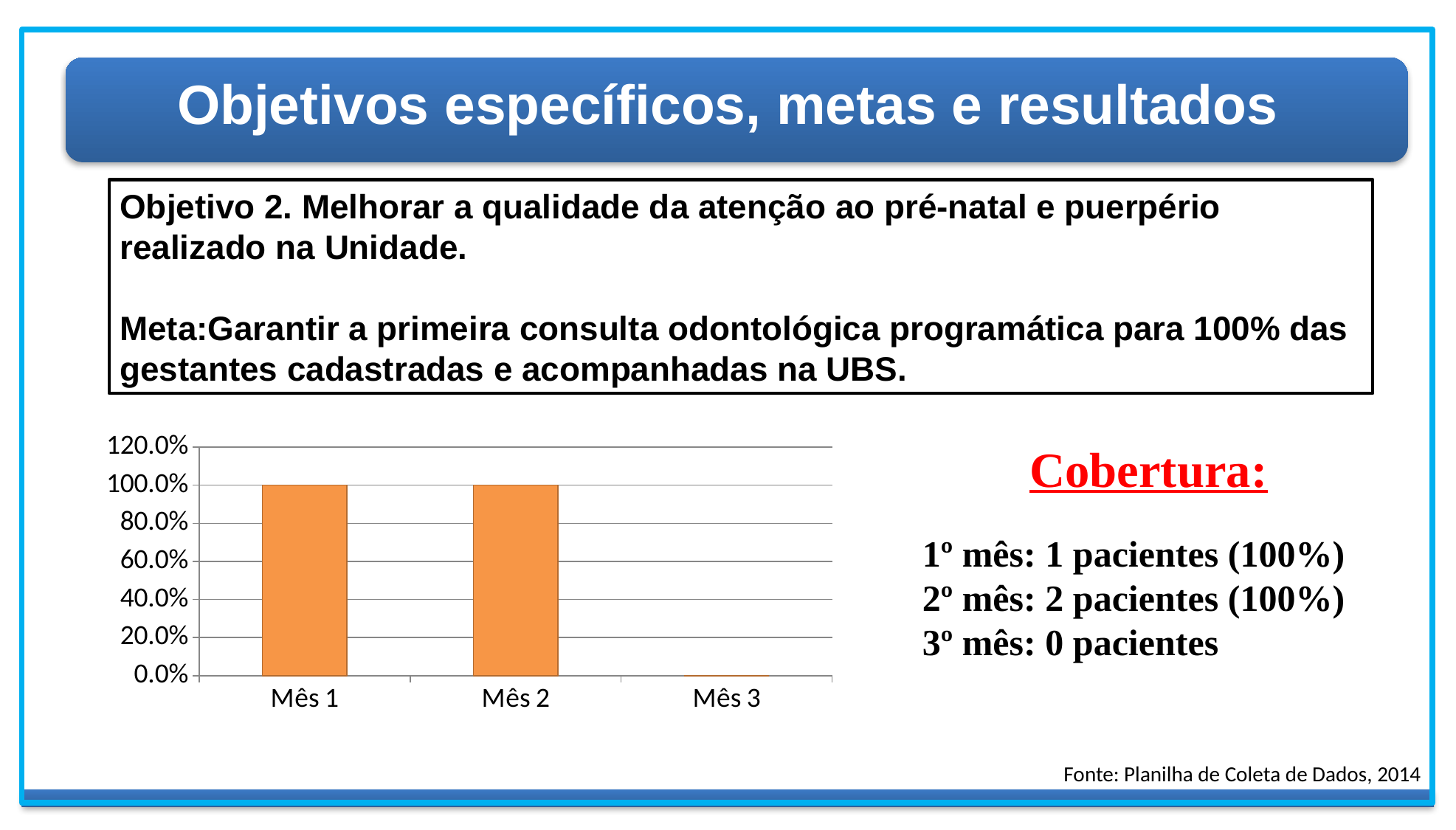
How many categories are shown on the x axis of the bar chart? 3 Does the value rise or fall from Mês 2 to Mês 3 in the bar chart? fall Which category has the lowest value in the bar chart? Mês 3 What is the value for Mês 1 in the bar chart? 100.0% What is the difference between the values for Mês 2 and Mês 3 in the bar chart? 100.0% What is the value for Mês 3 in the bar chart? 0.0% What is the value for Mês 2 in the bar chart? 100.0% Which is larger in the bar chart, the value for Mês 1 or the value for Mês 3? Mês 1 What kind of chart is shown on the slide? bar chart What colour are the bars in the chart? orange Is the value for Mês 1 greater or less than 80.0%? greater Is the value for Mês 3 greater or less than 20.0%? less